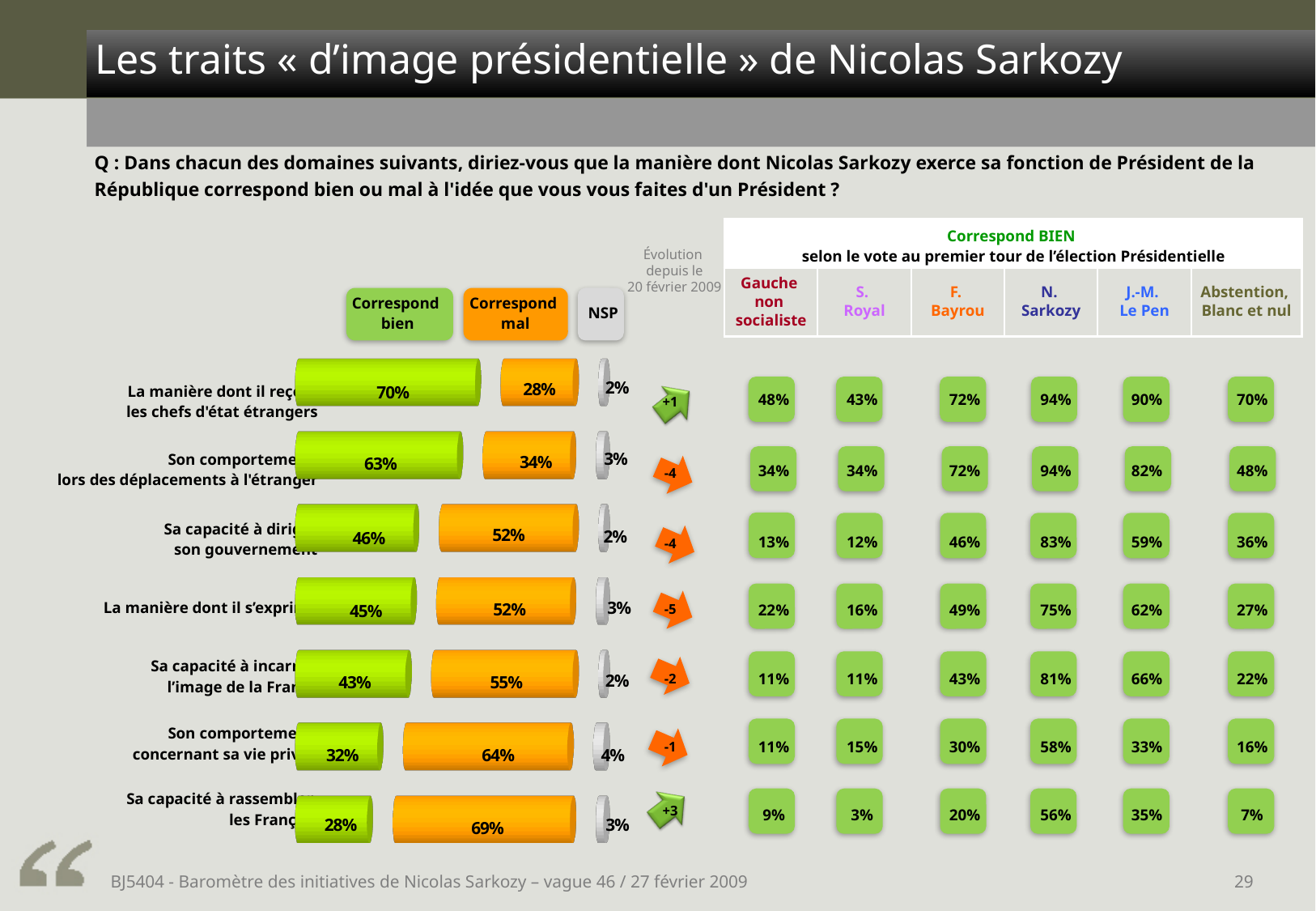
What is the "Correspond mal" value for "Sa capacité à rassembler les Français"? 69% What is the total of the three segments for "Son comportement lors des déplacements à l'étranger"? 100% What is the NSP value for "Son comportement concernant sa vie privée"? 4% What kind of chart is used to show the "Correspond bien", "Correspond mal" and NSP results? Stacked bar chart What colour represents the "Correspond mal" series in the chart? Orange How many items (categories) are shown in the bar chart? 7 What percentage of respondents say the way Nicolas Sarkozy receives foreign heads of state ("La manière dont il reçoit les chefs d'état étrangers") corresponds well ("Correspond bien")? 70% How many series does the chart legend list? 3 Which item has the highest "Correspond bien" value? La manière dont il reçoit les chefs d'état étrangers What is the difference between the "Correspond bien" and "Correspond mal" values for "Sa capacité à diriger son gouvernement"? 6% For "Sa capacité à incarner l'image de la France", which is larger: "Correspond bien" or "Correspond mal"? Correspond mal Which item has the lowest "Correspond bien" value? Sa capacité à rassembler les Français